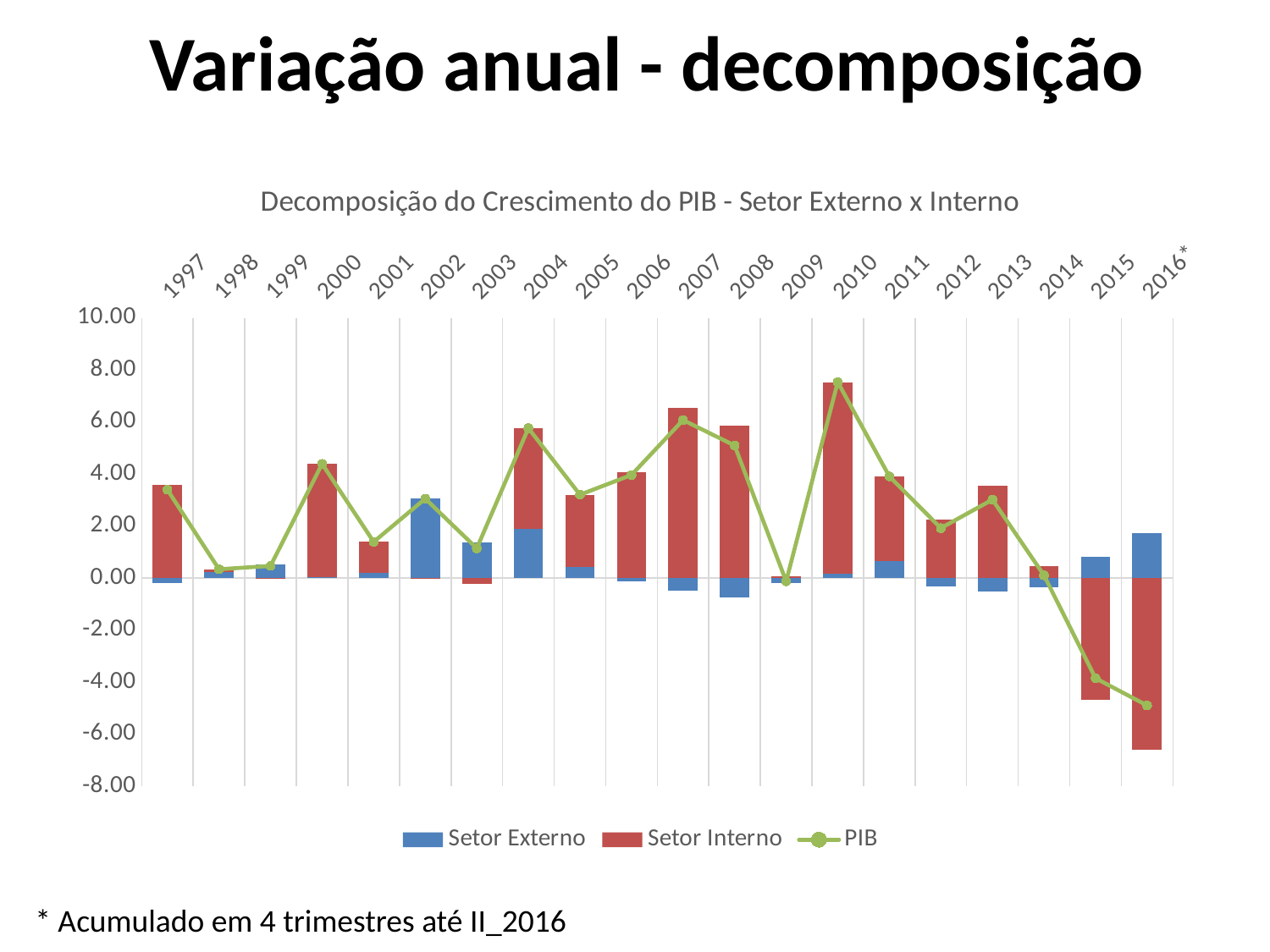
What kind of chart is shown on the slide? Stacked bar chart with a line What is the title of the chart on the slide? Decomposição do Crescimento do PIB - Setor Externo x Interno How many years (categories) are shown on the x axis of the chart? 20 In which year does the PIB line reach its highest value? 2010 Is the PIB value for 2010 greater or less than 6.00? greater Which year has the larger PIB value, 2007 or 2008? 2007 Is the Setor Externo value for 2002 greater or less than 2.00? greater Is the Setor Interno value for 2015 greater or less than -4.00? less How many series does the chart legend list? 3 Which series is shown in red in the chart? Setor Interno In which year does the PIB line reach its lowest value? 2016*